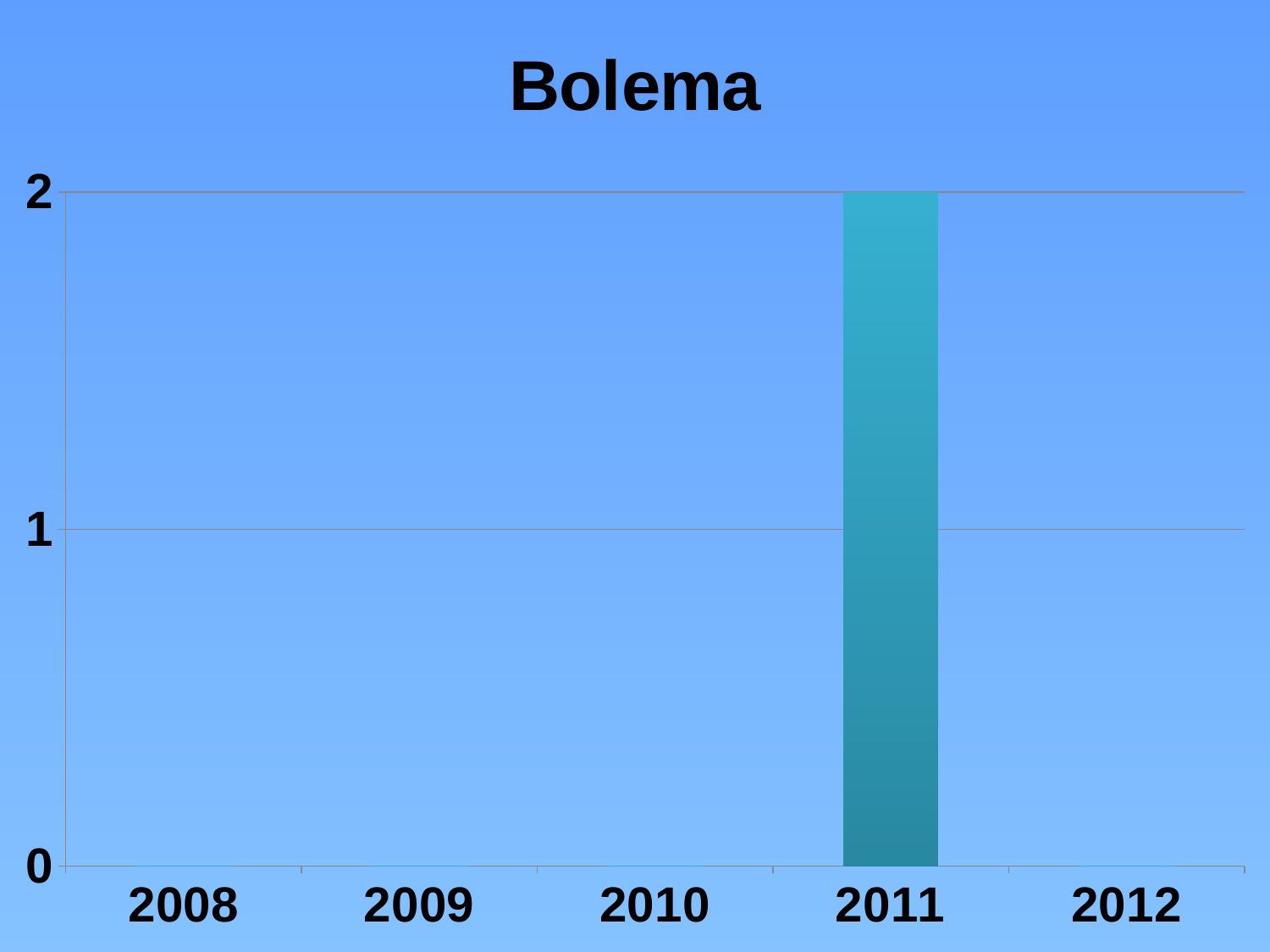
What is the value for 2009? 0 What is the difference between the value for 2011 and the value for 2012? 2 What is the value for 2011? 2 What is the highest value labelled on the y axis? 2 What is the first year shown on the x axis? 2008 What kind of chart is shown on the slide? bar chart Which has the larger value, 2010 or 2011? 2011 Which year has the highest value in the chart? 2011 Is the value for 2011 greater or less than 1? greater How many years are shown on the x axis of the chart? 5 What is the title of the chart? Bolema